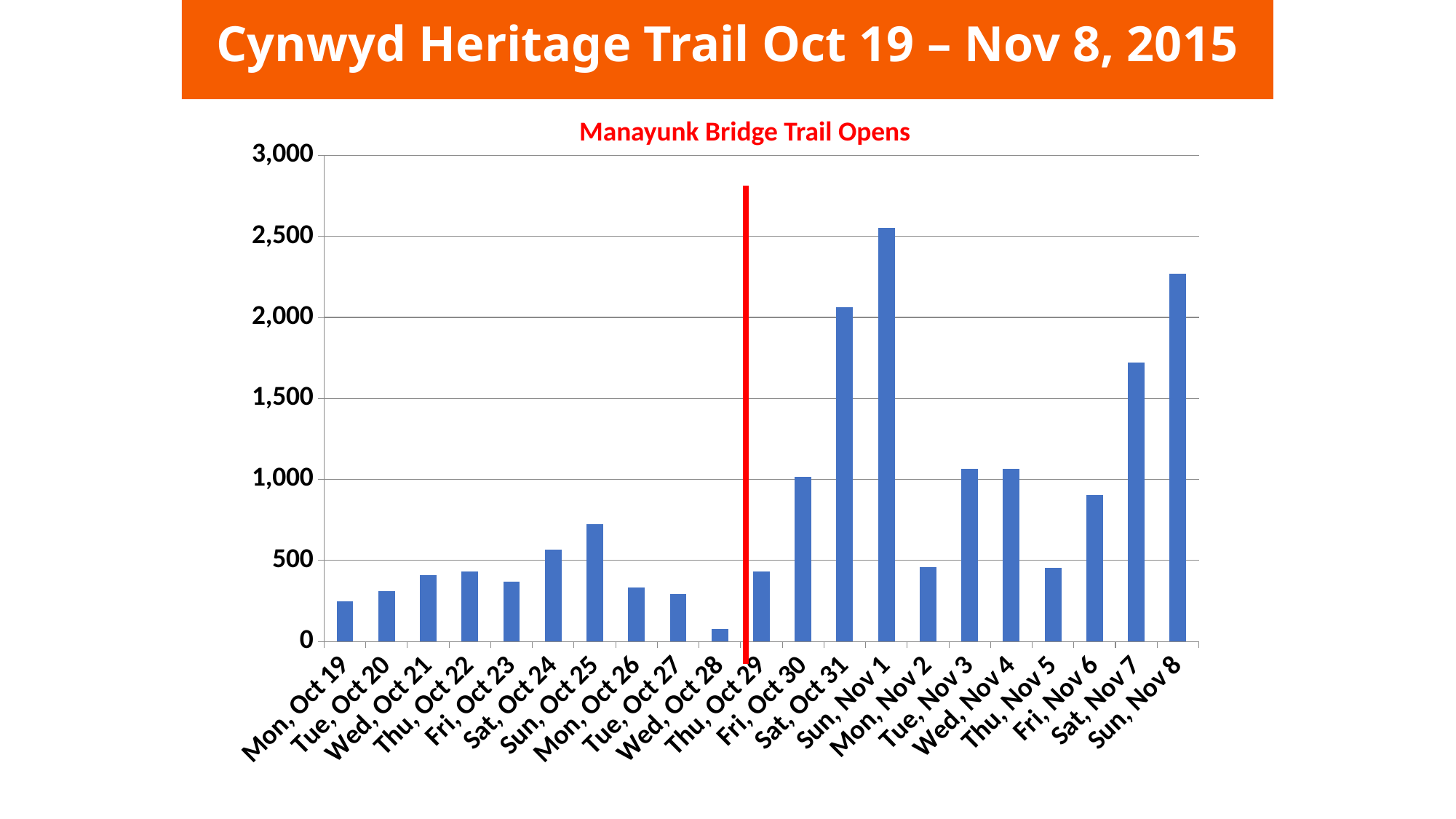
Is the value for Sun, Nov 8 greater or less than 2,000? greater What event does the red annotation above the chart mark? Manayunk Bridge Trail Opens Is the value for Sat, Nov 7 greater or less than 1,500? greater Is the value for Wed, Oct 28 greater or less than 500? less Which is larger, the value for Sat, Oct 31 or the value for Sun, Oct 25? Sat, Oct 31 Which day has the lowest value on the chart? Wed, Oct 28 How many days (bars) are plotted on the chart? 21 Which is larger, the value for Sun, Nov 8 or the value for Sat, Nov 7? Sun, Nov 8 Which day has the highest value on the chart? Sun, Nov 1 What kind of chart is shown on the slide? bar chart